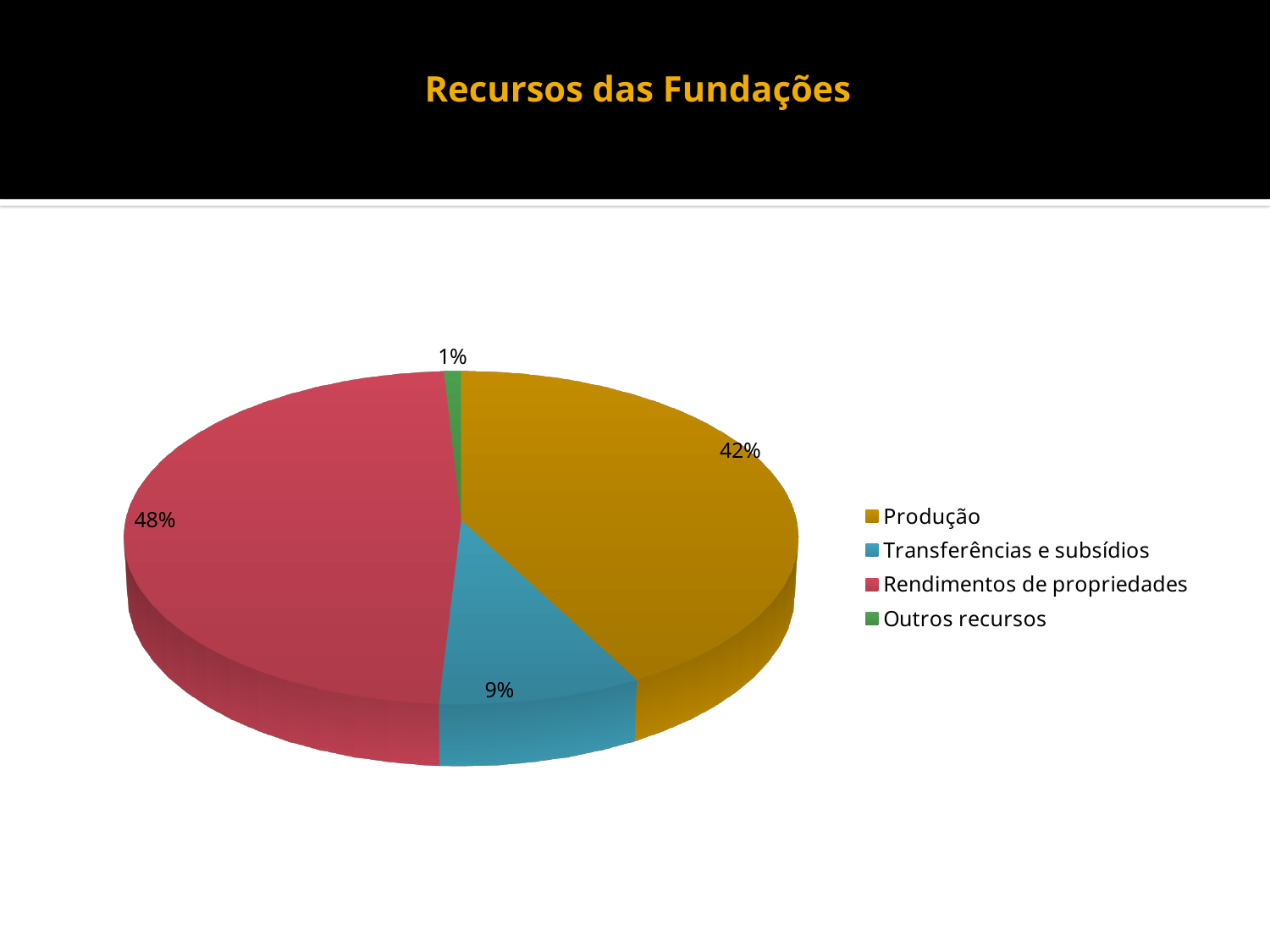
How many categories does the legend list? 4 What is the difference in percentage points between Rendimentos de propriedades and Produção? 6 What share of the pie does Transferências e subsídios represent? 9% What is the title of the chart? Recursos das Fundações What share of the pie does Outros recursos represent? 1% What kind of chart is shown on the slide? pie chart What colour is the slice for Transferências e subsídios? blue What share of the pie does Produção represent? 42% Which category has the smallest share of the pie? Outros recursos Which is larger, the share for Produção or the share for Transferências e subsídios? Produção Which category has the largest share of the pie? Rendimentos de propriedades